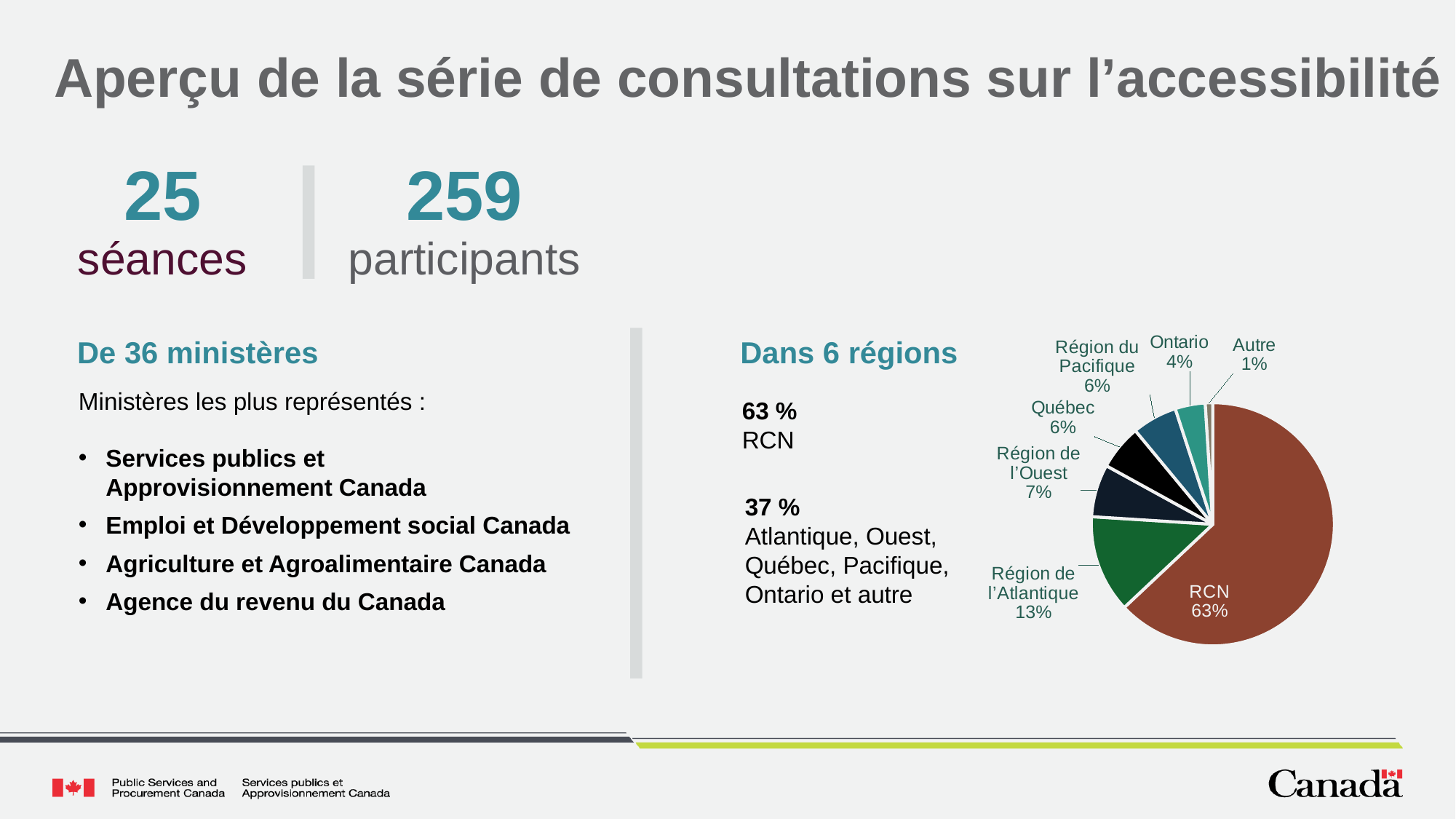
What share of the pie does Québec represent? 6% What share of the pie does Région de l'Atlantique represent? 13% What share of the pie does Région de l'Ouest represent? 7% Which slice of the pie is the smallest? Autre What is the difference between the RCN share and the Région de l'Atlantique share? 50% Which is larger, the share for Région de l'Ouest or the share for Ontario? Région de l'Ouest How many slices does the pie chart have? 7 What colour is the RCN slice of the pie? brown What kind of chart is shown on the slide? pie chart Which slice of the pie is the largest? RCN